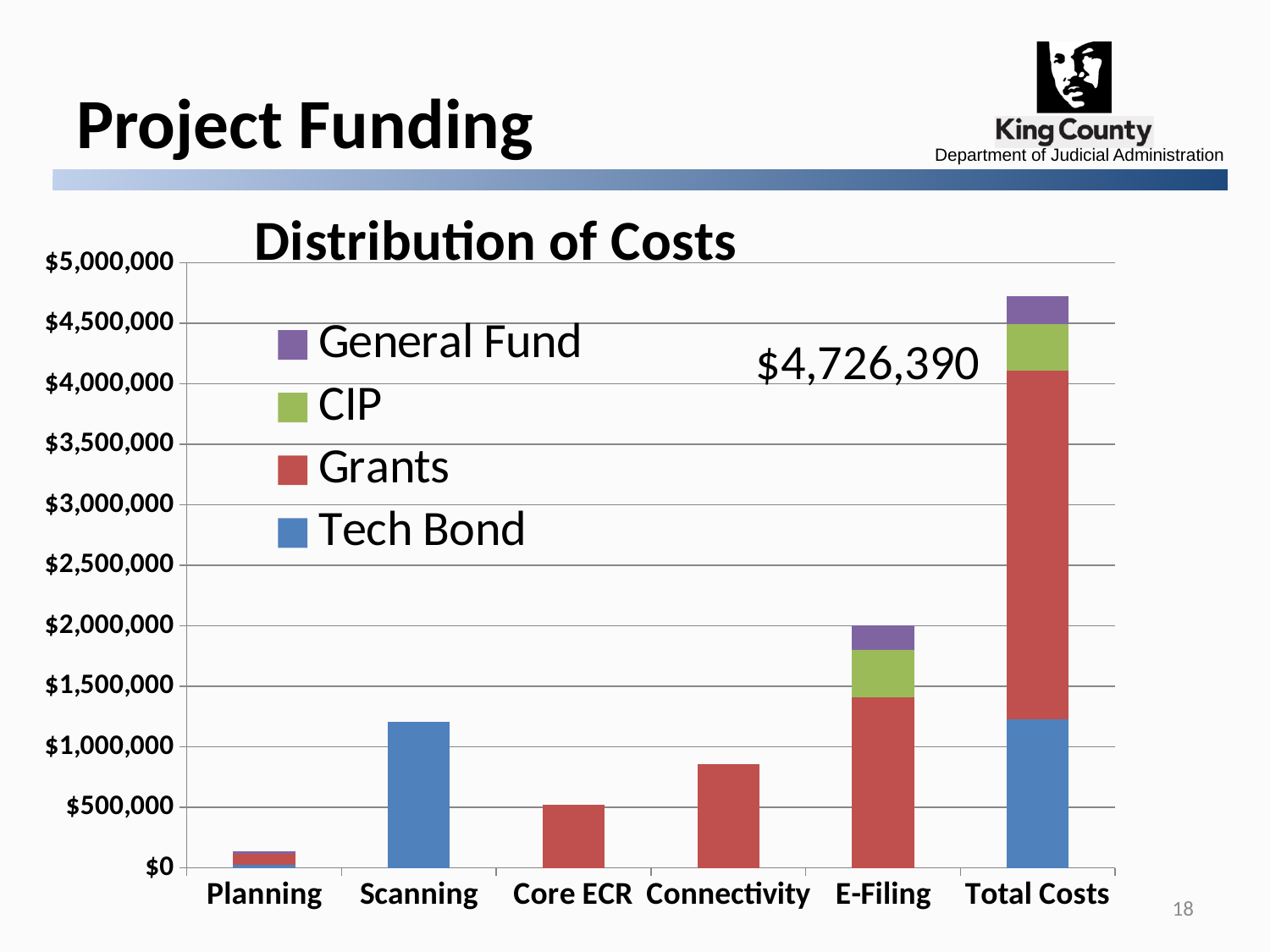
Is the value for Core ECR greater or less than $1,000,000? less What is the title of the chart? Distribution of Costs Which category has the shortest bar in the chart? Planning What is the total value shown for the Total Costs bar? $4,726,390 Is the value for Scanning greater or less than $1,000,000? greater How many categories are shown along the x axis of the chart? 6 Is the total value for E-Filing greater or less than $1,500,000? greater Which funding series makes up the entire Scanning bar? Tech Bond How many series does the chart's legend list? 4 Which category has the tallest bar in the chart? Total Costs What kind of chart is shown on the slide? bar chart Which bar is taller, Scanning or Connectivity? Scanning